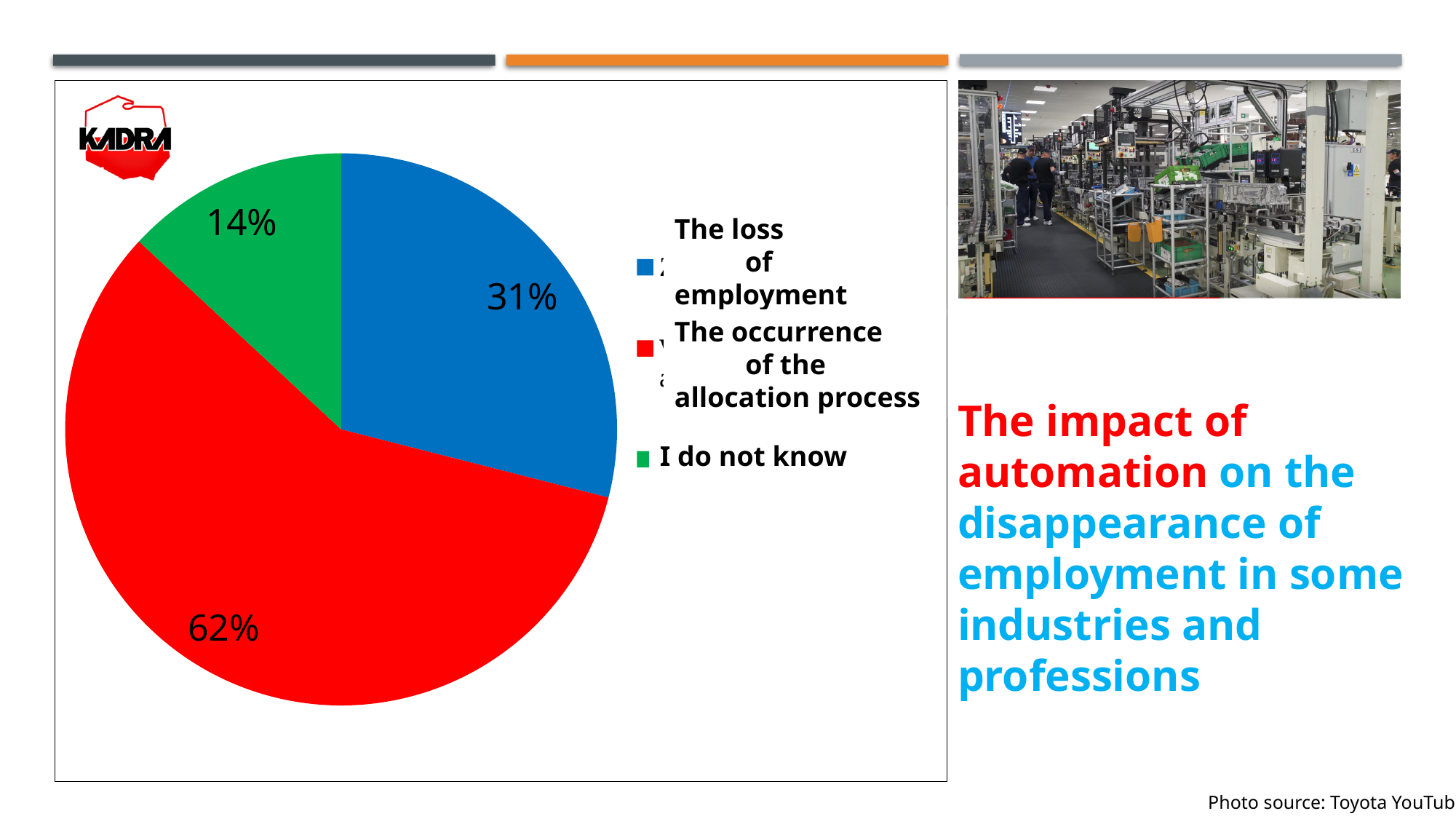
What kind of chart is shown on the slide? pie chart Which is larger: the slice for "The loss of employment" or the slice for "I do not know"? The loss of employment How many entries does the legend of the pie chart list? 3 What percentage is shown for the slice labelled "The loss of employment"? 31% What is the difference in percentage points between "The occurrence of the allocation process" and "The loss of employment"? 31 What percentage is shown for the slice labelled "I do not know"? 14% What colour is the slice for "I do not know" in the pie chart? green What percentage is shown for the slice labelled "The occurrence of the allocation process"? 62% Which slice of the pie chart is the smallest? I do not know How many slices does the pie chart have? 3 Which slice of the pie chart is the largest? The occurrence of the allocation process What colour is the slice for "The occurrence of the allocation process" in the pie chart? red